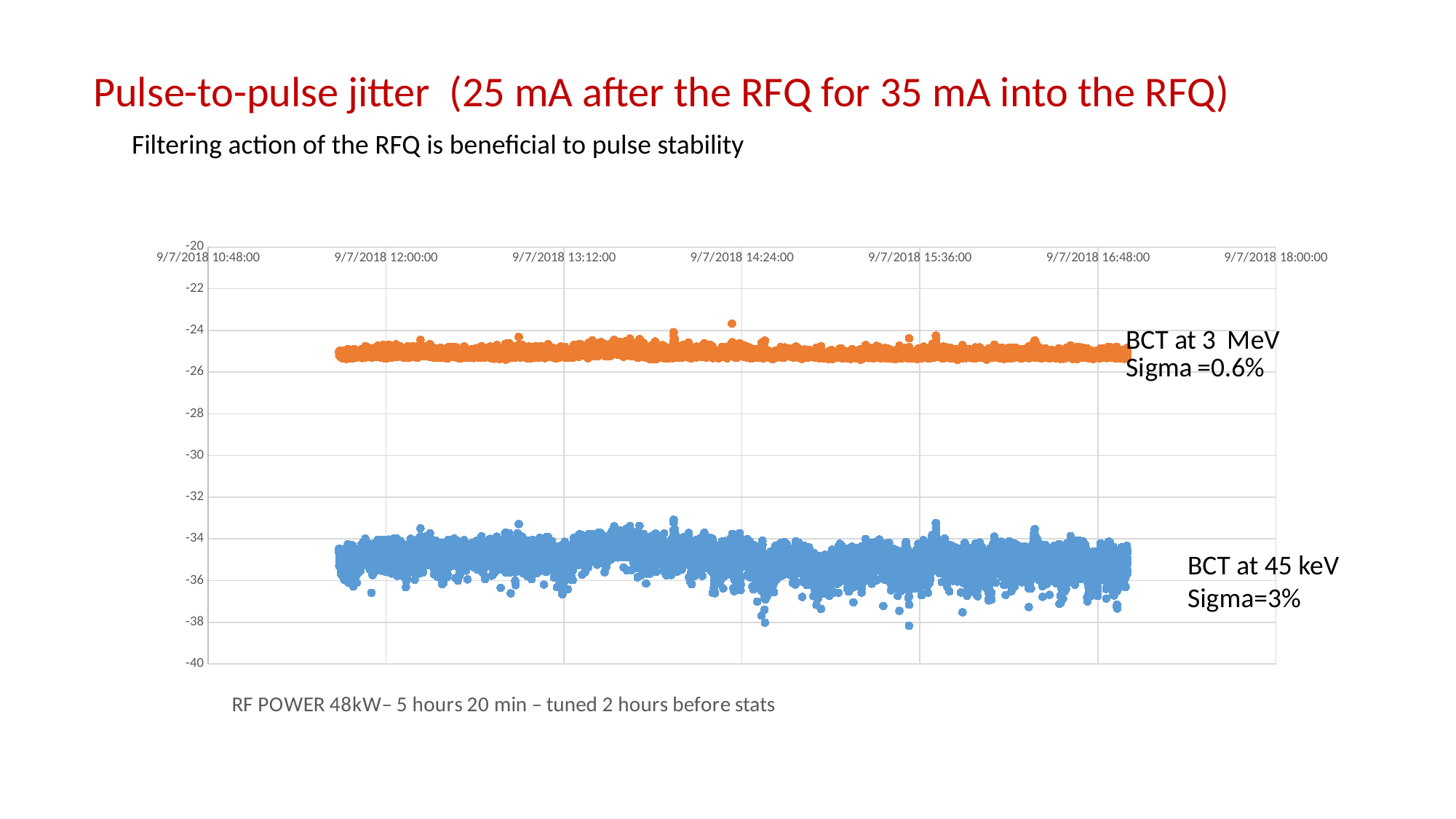
What is the sigma value given for the BCT at 3 MeV series? 0.6% What colour are the points of the BCT at 45 keV series? Blue Which series has the larger sigma, BCT at 3 MeV or BCT at 45 keV? BCT at 45 keV Are the values for the BCT at 45 keV series greater or less than -32? less Are the values for the BCT at 45 keV series greater or less than -30? less How many data series are plotted on the chart? 2 Do the values of the BCT at 3 MeV series show a clear rising or falling trend over time, or stay roughly flat? Roughly flat Which series sits higher on the y axis, BCT at 3 MeV or BCT at 45 keV? BCT at 3 MeV What RF power is stated in the note below the chart? 48kW What kind of chart is shown on the slide? Scatter chart What is the sigma value given for the BCT at 45 keV series? 3% Are the values for the BCT at 3 MeV series greater or less than -30? greater